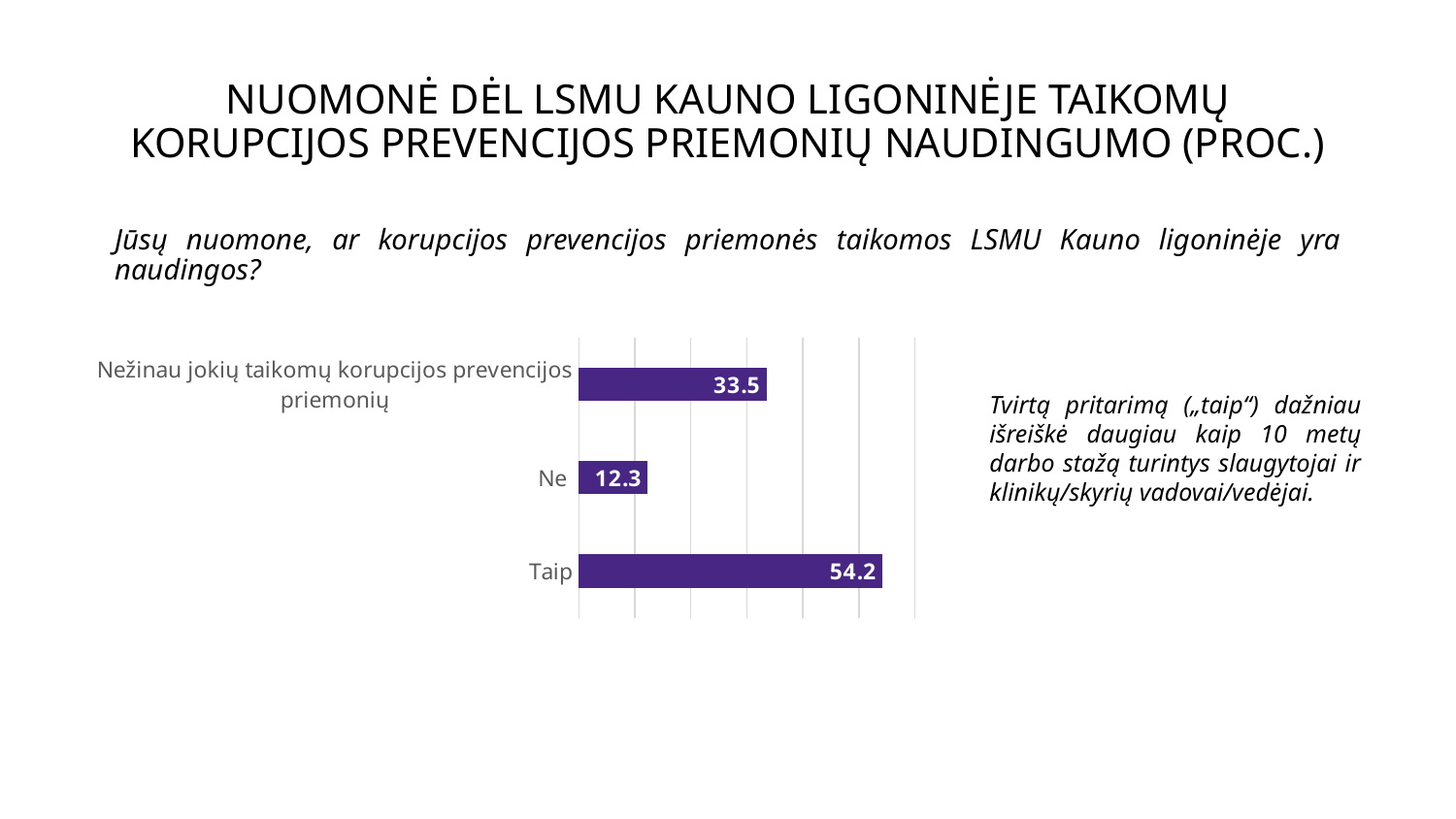
How many categories are shown in the chart? 3 Which category has the lowest value? Ne What is the value for "Ne"? 12.3 What is the difference between the values for "Taip" and "Nežinau jokių taikomų korupcijos prevencijos priemonių"? 20.7 Which is larger, the value for "Ne" or the value for "Nežinau jokių taikomų korupcijos prevencijos priemonių"? Nežinau jokių taikomų korupcijos prevencijos priemonių Which category has the highest value? Taip What kind of chart is shown on the slide? Bar chart Are the bars in the chart horizontal or vertical? Horizontal What is the value for "Nežinau jokių taikomų korupcijos prevencijos priemonių"? 33.5 What is the difference between the values for "Taip" and "Ne"? 41.9 What colour are the bars in the chart? Purple What is the value for "Taip"? 54.2